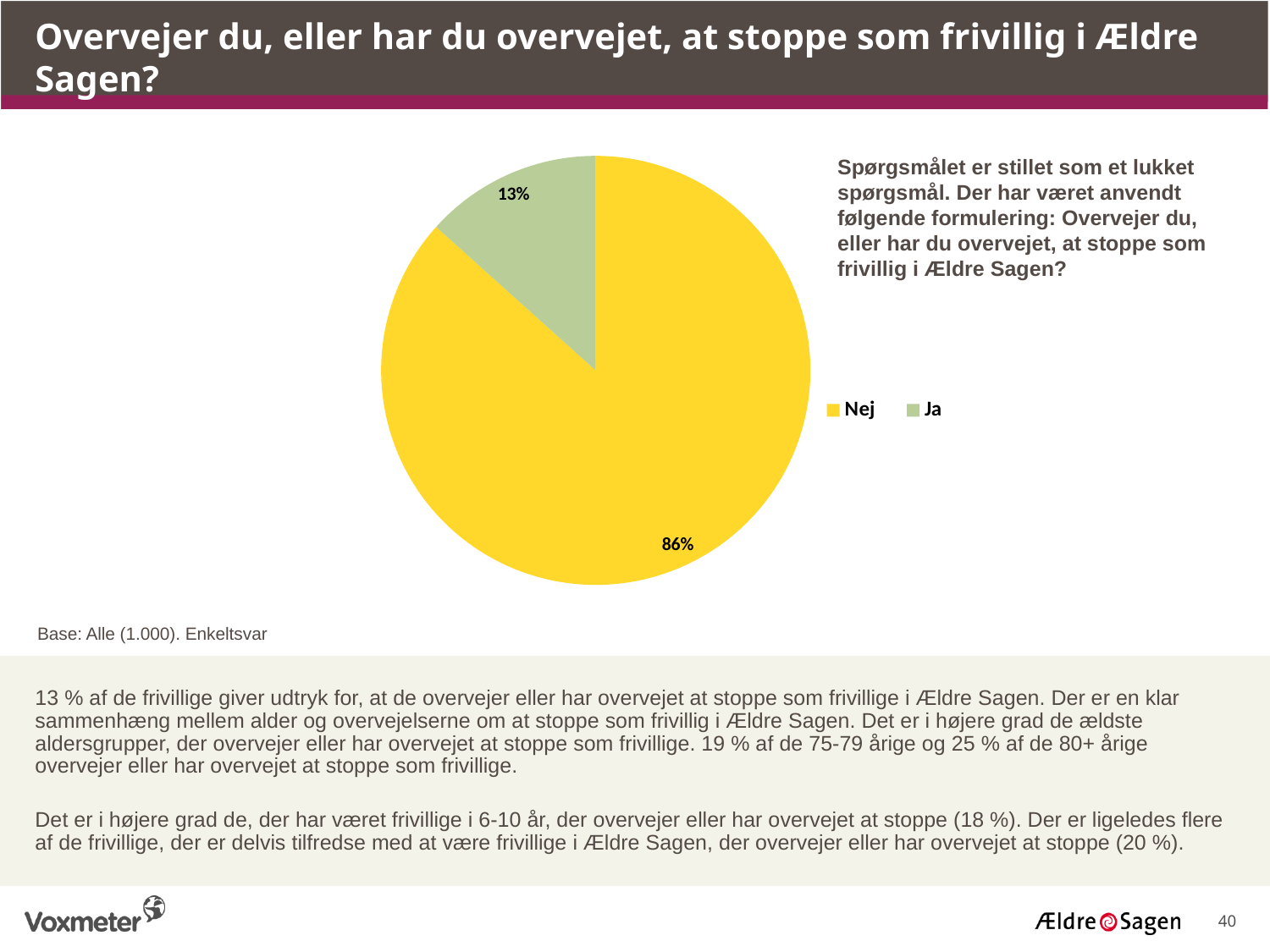
Which slice of the pie is the largest? Nej What colour is the "Nej" slice in the pie chart? yellow What share of the pie does the "Nej" slice represent? 86% How many entries does the legend list? 2 What share of the pie does the "Ja" slice represent? 13% How many slices does the pie chart have? 2 Which is larger, the "Ja" slice or the "Nej" slice? Nej What colour is the "Ja" slice in the pie chart? light green What kind of chart is shown on the slide? pie chart Which slice of the pie is the smallest? Ja What is the difference in percentage points between the "Nej" and "Ja" slices? 73